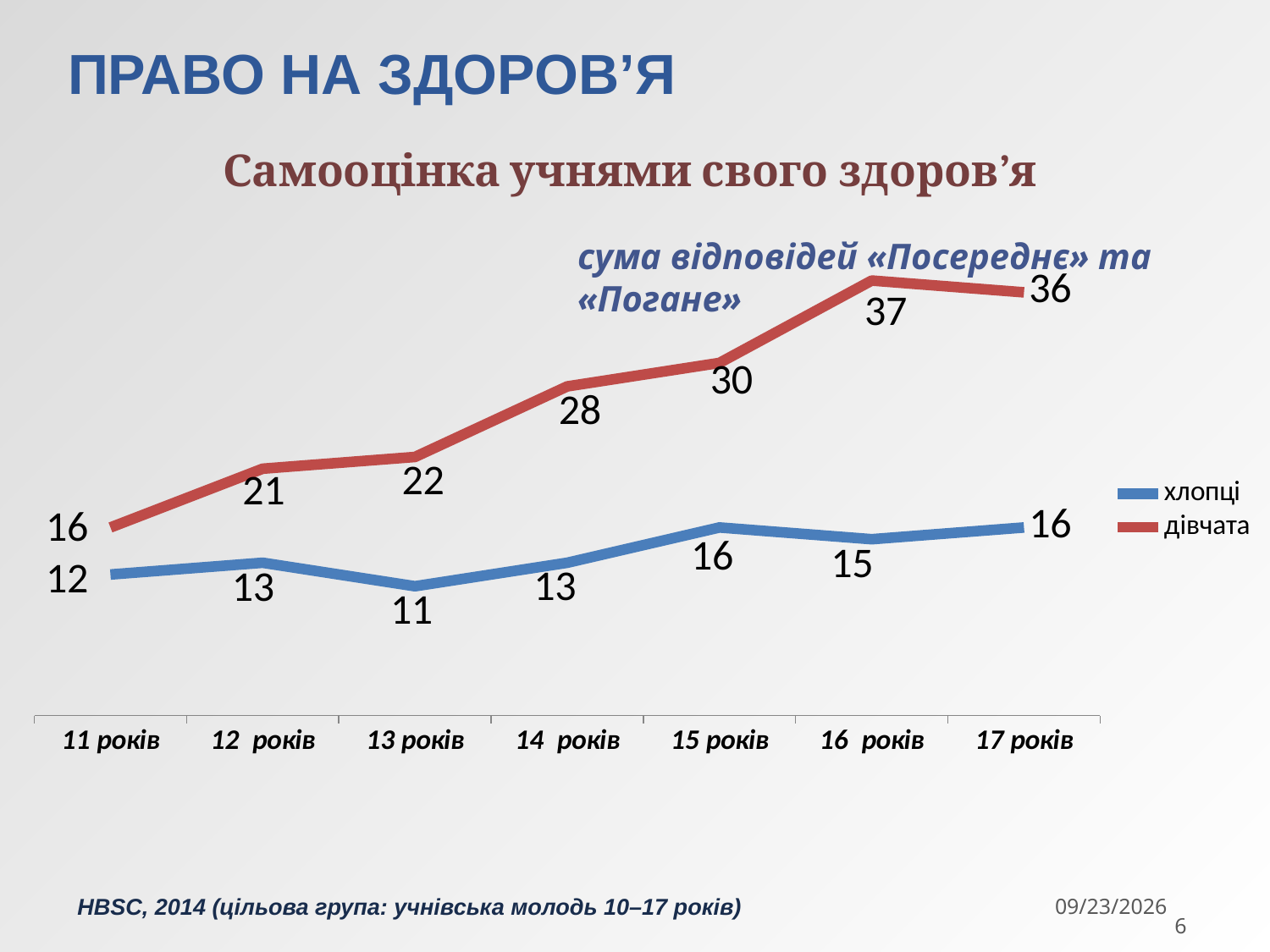
What is the value for хлопці at 13 років? 11 How many age categories are shown on the x axis? 7 At which age is the value for дівчата highest? 16 років What is the value for дівчата at 14 років? 28 What kind of chart is shown on the slide? line chart Which series has the larger value at 11 років, хлопці or дівчата? дівчата Which colour is used for the дівчата series? red Does the value for дівчата generally rise or fall from 11 років to 16 років? rise How many series does the legend list? 2 At which age is the value for хлопці lowest? 13 років What is the value for дівчата at 17 років? 36 What is the difference between дівчата and хлопці at 16 років? 22